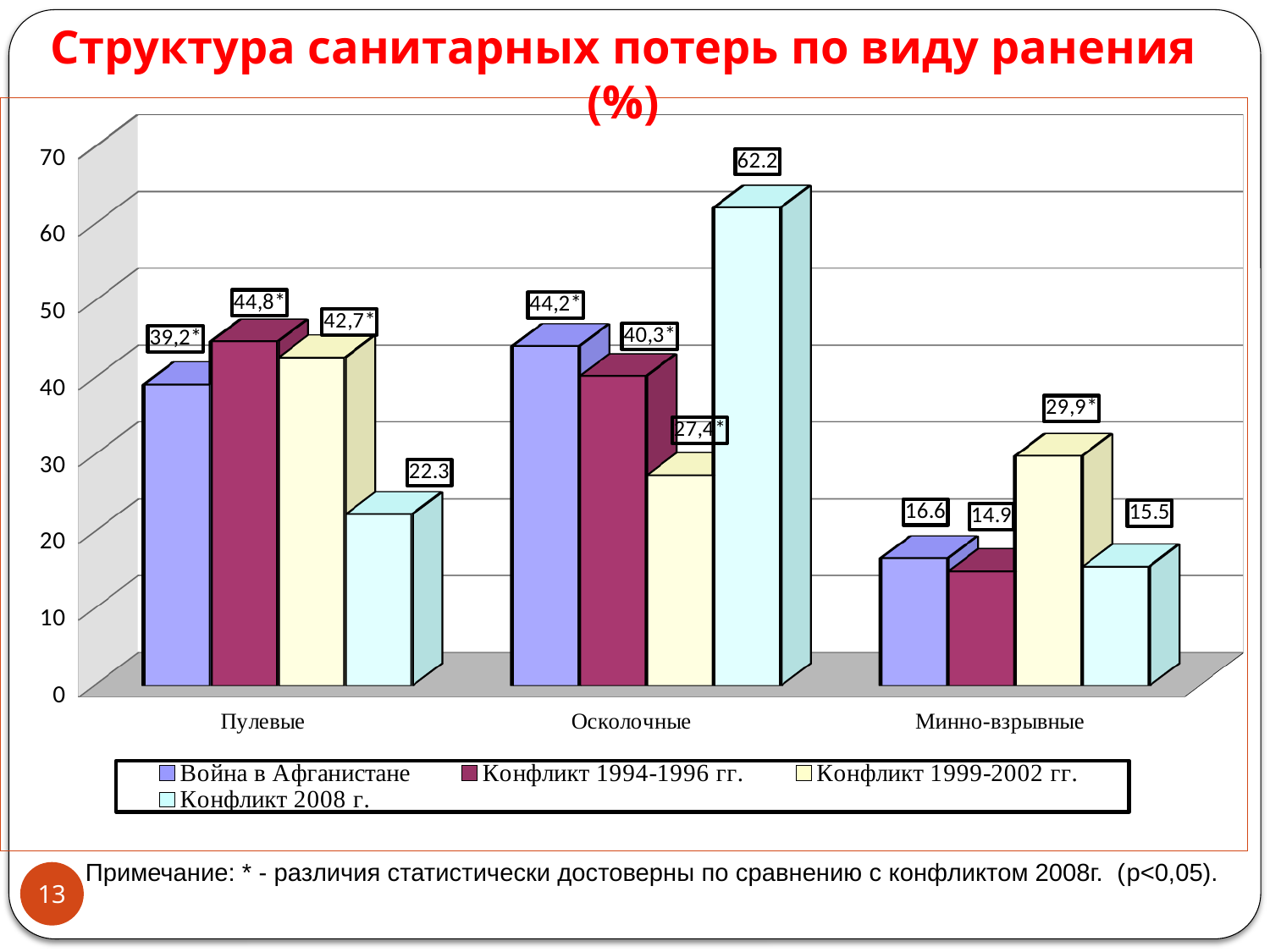
How many categories are shown on the x axis? 3 How many series does the legend list? 4 Which is larger in the Пулевые category: Конфликт 1994-1996 гг. or Конфликт 2008 г.? Конфликт 1994-1996 гг. What is the difference between the Конфликт 2008 г. values for Осколочные and Пулевые? 39.9 What is the title of the chart? Структура санитарных потерь по виду ранения (%) What is the value for Конфликт 1994-1996 гг. in the Осколочные category? 40,3* What type of chart is shown on the slide? bar chart Which series has the highest value in the Осколочные category? Конфликт 2008 г. What is the value for Конфликт 1999-2002 гг. in the Минно-взрывные category? 29,9* What is the value for Война в Афганистане in the Пулевые category? 39,2* Which series has the lowest value in the Минно-взрывные category? Конфликт 1994-1996 гг. What is the value for Конфликт 2008 г. in the Осколочные category? 62.2